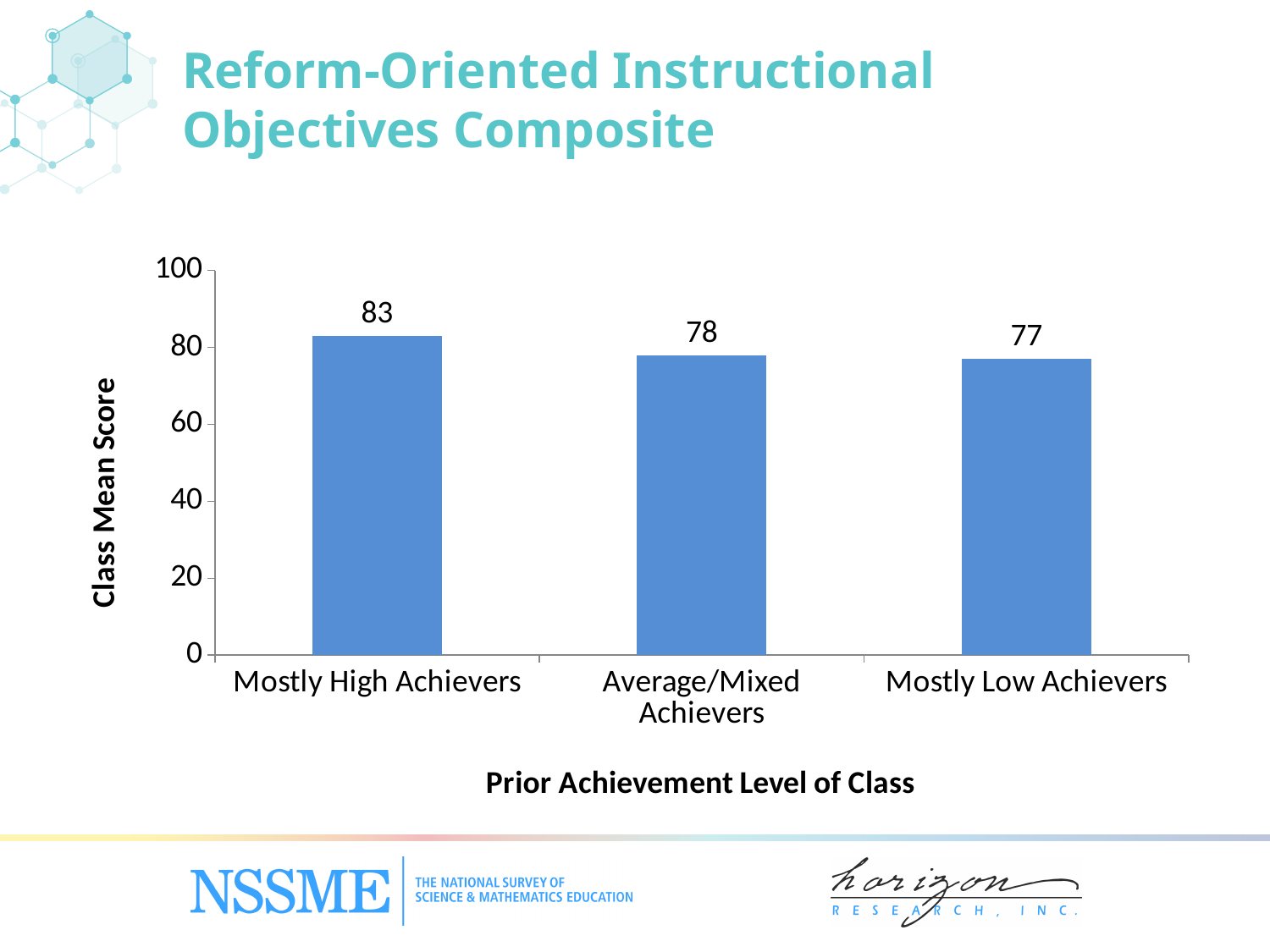
What kind of chart is shown on the slide? Bar chart How many prior achievement level categories are shown on the chart? 3 What is the label of the x axis? Prior Achievement Level of Class What is the class mean score for Mostly High Achievers? 83 Which prior achievement level has the highest class mean score? Mostly High Achievers Is the value for Mostly Low Achievers greater or less than 80? less What is the difference between the class mean scores for Mostly High Achievers and Average/Mixed Achievers? 5 What is the difference between the class mean scores for Mostly High Achievers and Mostly Low Achievers? 6 Is the value for Mostly High Achievers greater or less than 80? greater What is the class mean score for Average/Mixed Achievers? 78 Which has a larger class mean score, Mostly High Achievers or Average/Mixed Achievers? Mostly High Achievers What is the class mean score for Mostly Low Achievers? 77